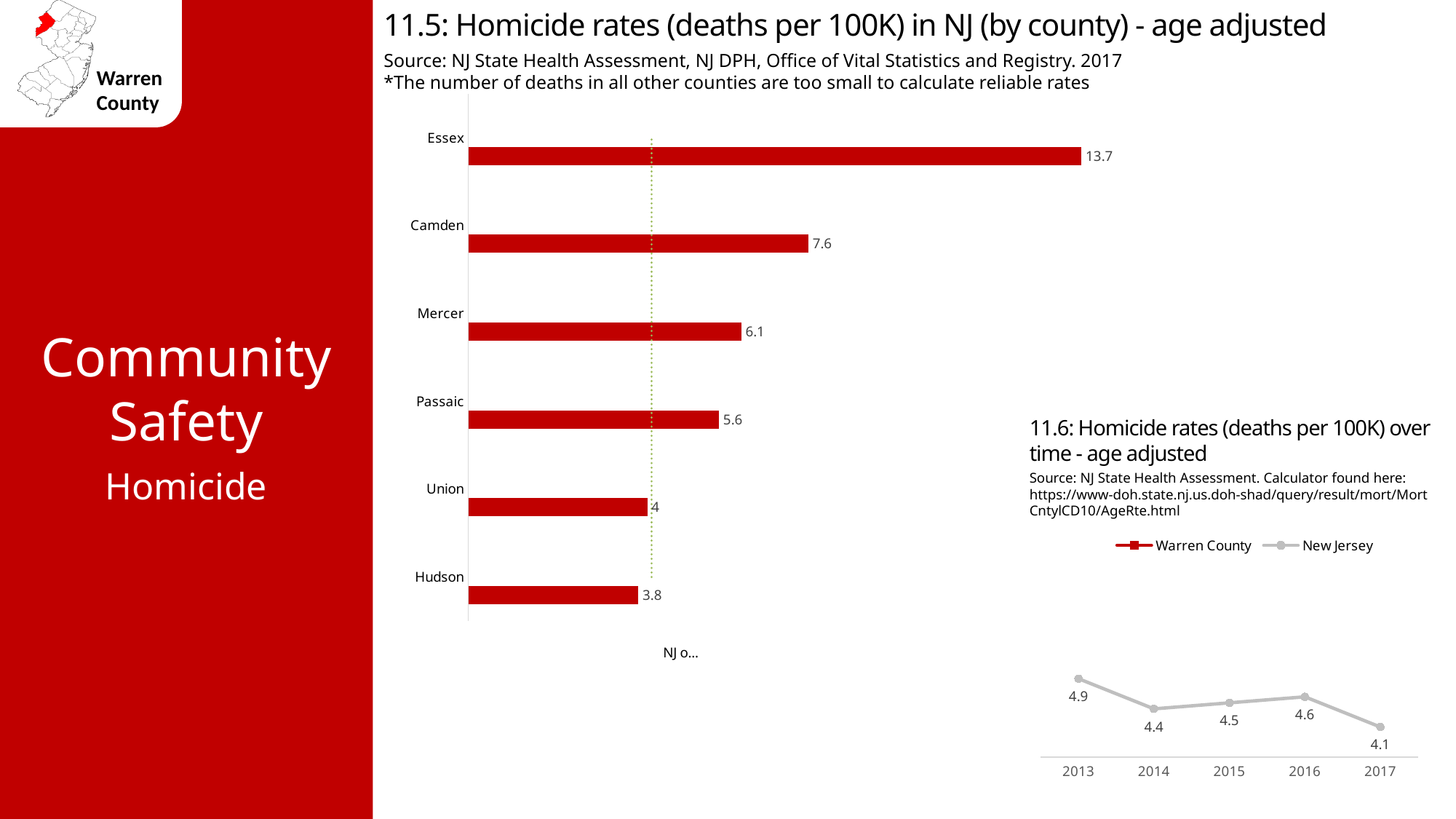
In chart 11.6 (Homicide rates over time), what is the difference between the New Jersey rates in 2013 and 2017? 0.8 In chart 11.5 (Homicide rates in NJ by county), what is the homicide rate for Union? 4 In chart 11.5 (Homicide rates in NJ by county), what is the difference between the rates for Essex and Camden? 6.1 In chart 11.5 (Homicide rates in NJ by county), which county has the highest homicide rate? Essex In chart 11.6 (Homicide rates over time), what is the New Jersey homicide rate in 2013? 4.9 In chart 11.5 (Homicide rates in NJ by county), which has a higher homicide rate, Mercer or Passaic? Mercer In chart 11.5 (Homicide rates in NJ by county), how many counties are shown? 6 In chart 11.5 (Homicide rates in NJ by county), what is the homicide rate for Camden? 7.6 In chart 11.5 (Homicide rates in NJ by county), which county has the lowest homicide rate? Hudson In chart 11.5 (Homicide rates in NJ by county), what is the homicide rate for Essex? 13.7 What kind of chart is chart 11.5 (Homicide rates in NJ by county)? Bar chart How many series does the legend of chart 11.6 (Homicide rates over time) list? 2